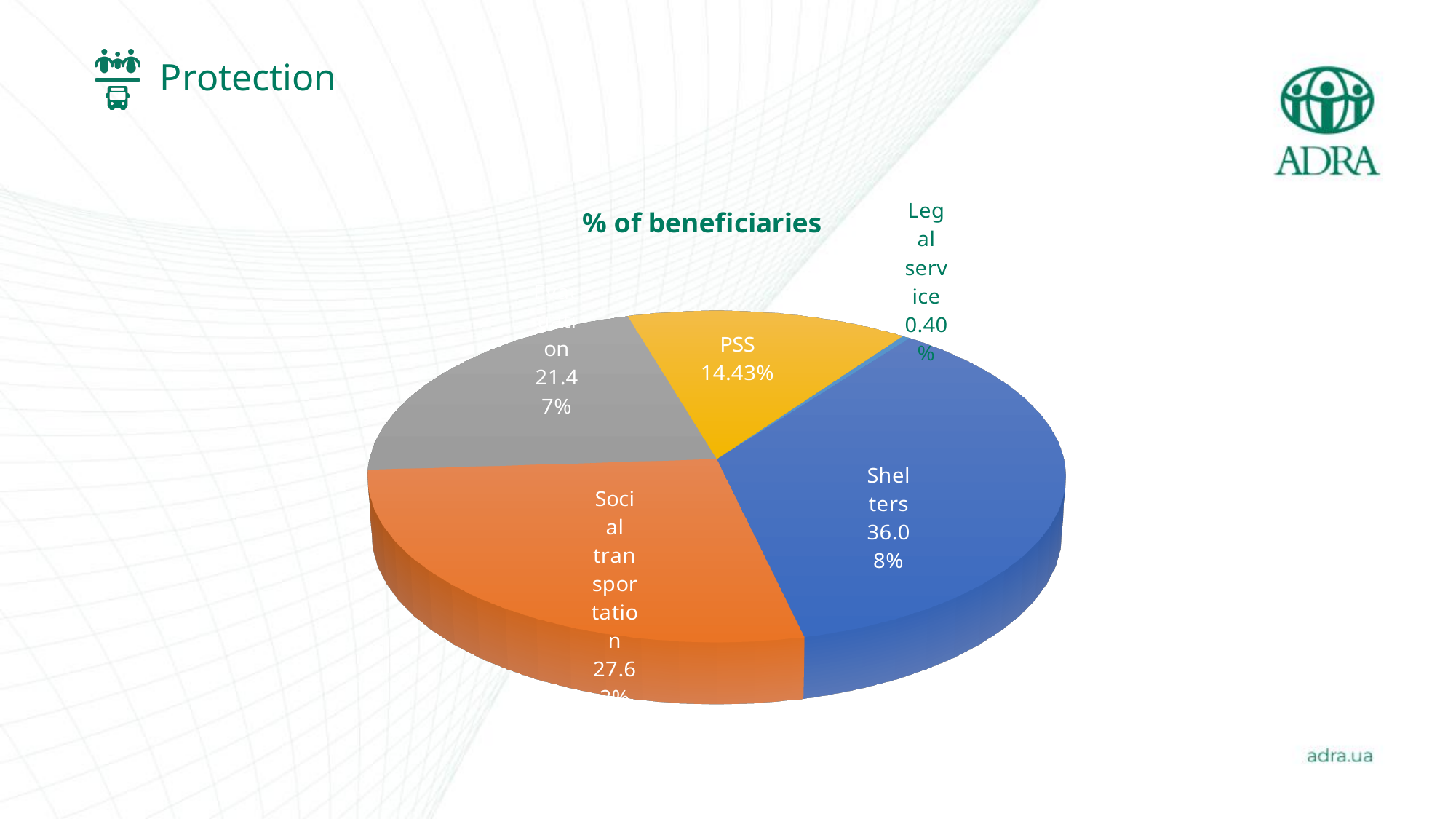
Which category has the smallest share of beneficiaries? Legal service How many slices does the pie chart have? 5 What kind of chart is shown on the slide? pie chart What colour is the Shelters slice? blue Which has a larger share of beneficiaries, Legal service or PSS? PSS Which has a larger share of beneficiaries, PSS or Shelters? Shelters What percentage of beneficiaries is shown for Shelters? 36.08% What percentage of beneficiaries is shown for PSS? 14.43% What is the title of the chart? % of beneficiaries What is the difference in percentage points between Shelters and PSS? 21.65% What percentage of beneficiaries is shown for Legal service? 0.40% Which category has the largest share of beneficiaries? Shelters